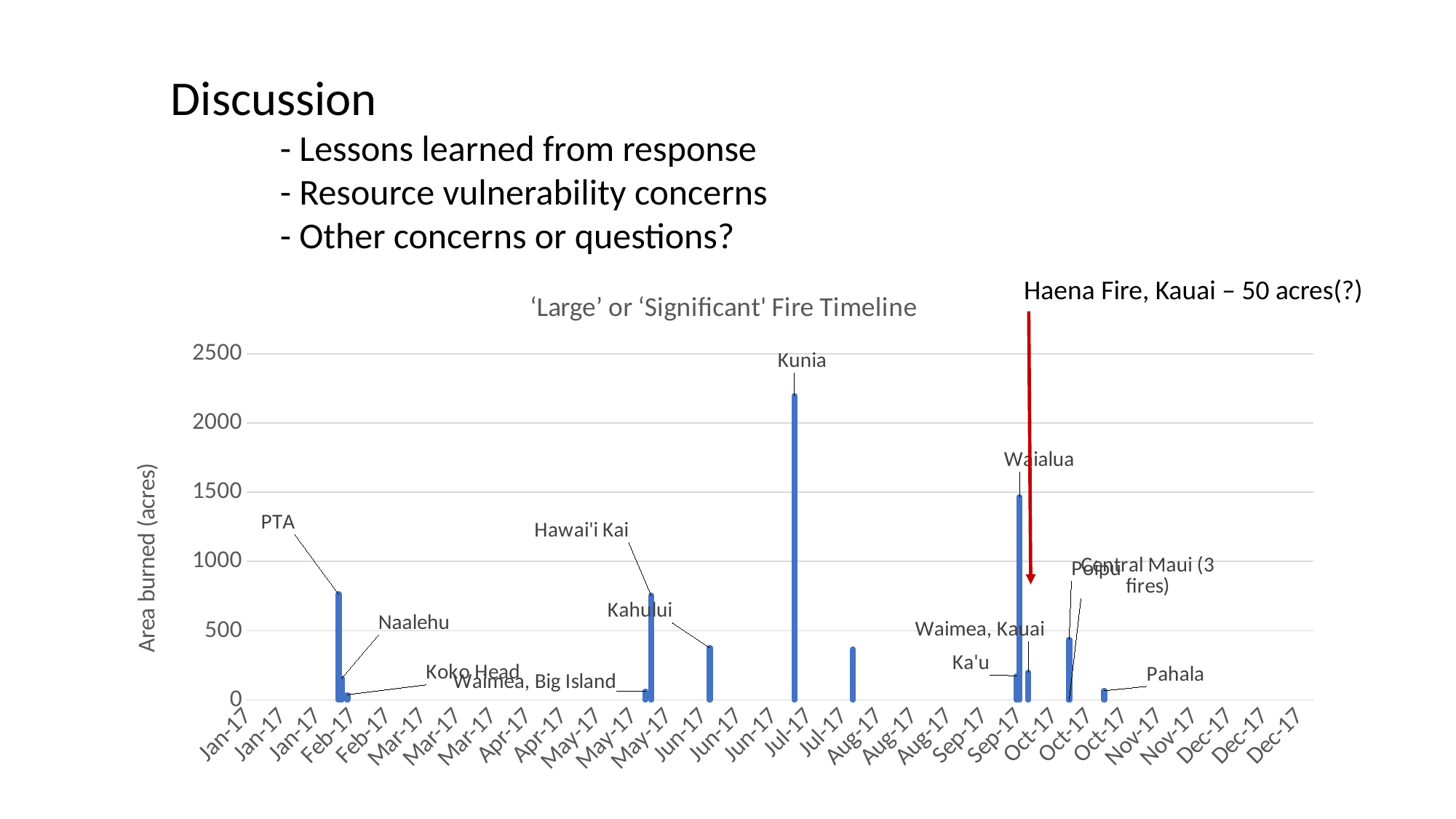
Which fire burned a larger area, Kunia or Waialua? Kunia Is the area burned for Waialua greater or less than 1000 acres? greater Is the area burned for Kahului greater or less than 500 acres? less Which fire burned a larger area, PTA or Kahului? PTA What is the label on the vertical axis of the chart? Area burned (acres) Which fire burned a larger area, Waialua or Hawai'i Kai? Waialua Is the area burned for PTA greater or less than 1000 acres? less What is the title of the chart? 'Large' or 'Significant' Fire Timeline Which labelled fire has the largest area burned in the chart? Kunia What kind of chart is shown on the slide? bar chart